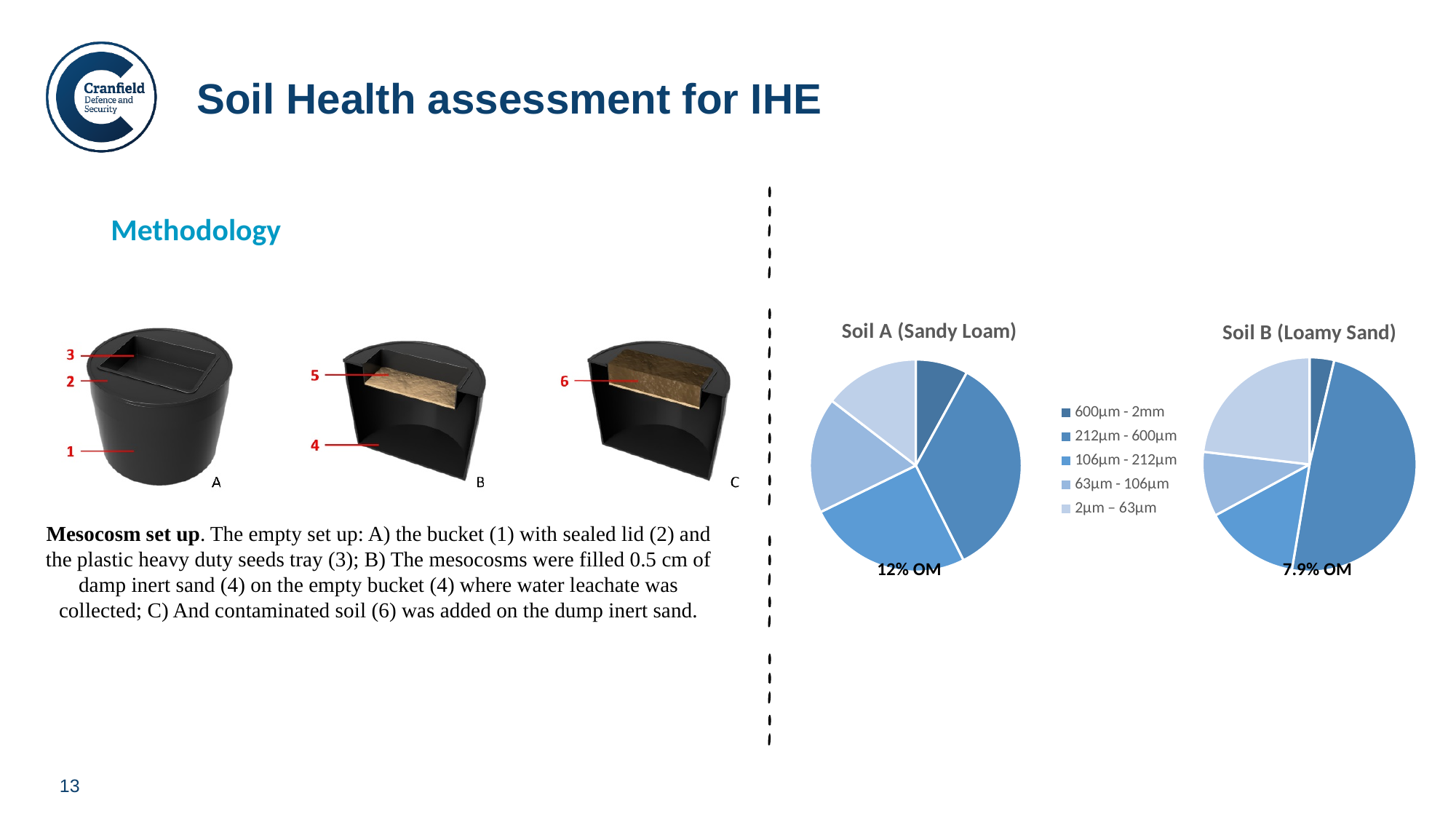
In the Soil A (Sandy Loam) pie chart, which slice is larger: 212µm - 600µm or 600µm - 2mm? 212µm - 600µm How many particle size categories does the legend list for the pie charts? 5 What kind of chart is used for Soil A (Sandy Loam)? Pie chart In the Soil B (Loamy Sand) pie chart, which particle size category has the largest slice? 212µm - 600µm Which soil has a larger 600µm - 2mm slice, Soil A (Sandy Loam) or Soil B (Loamy Sand)? Soil A (Sandy Loam) What organic matter (OM) percentage is shown below the Soil A (Sandy Loam) pie chart? 12% OM In the Soil A (Sandy Loam) pie chart, which particle size category has the smallest slice? 600µm - 2mm What organic matter (OM) percentage is shown below the Soil B (Loamy Sand) pie chart? 7.9% OM In the Soil B (Loamy Sand) pie chart, which particle size category has the smallest slice? 600µm - 2mm How many slices does the Soil B (Loamy Sand) pie chart have? 5 In the Soil B (Loamy Sand) pie chart, which slice is larger: 212µm - 600µm or 2µm – 63µm? 212µm - 600µm